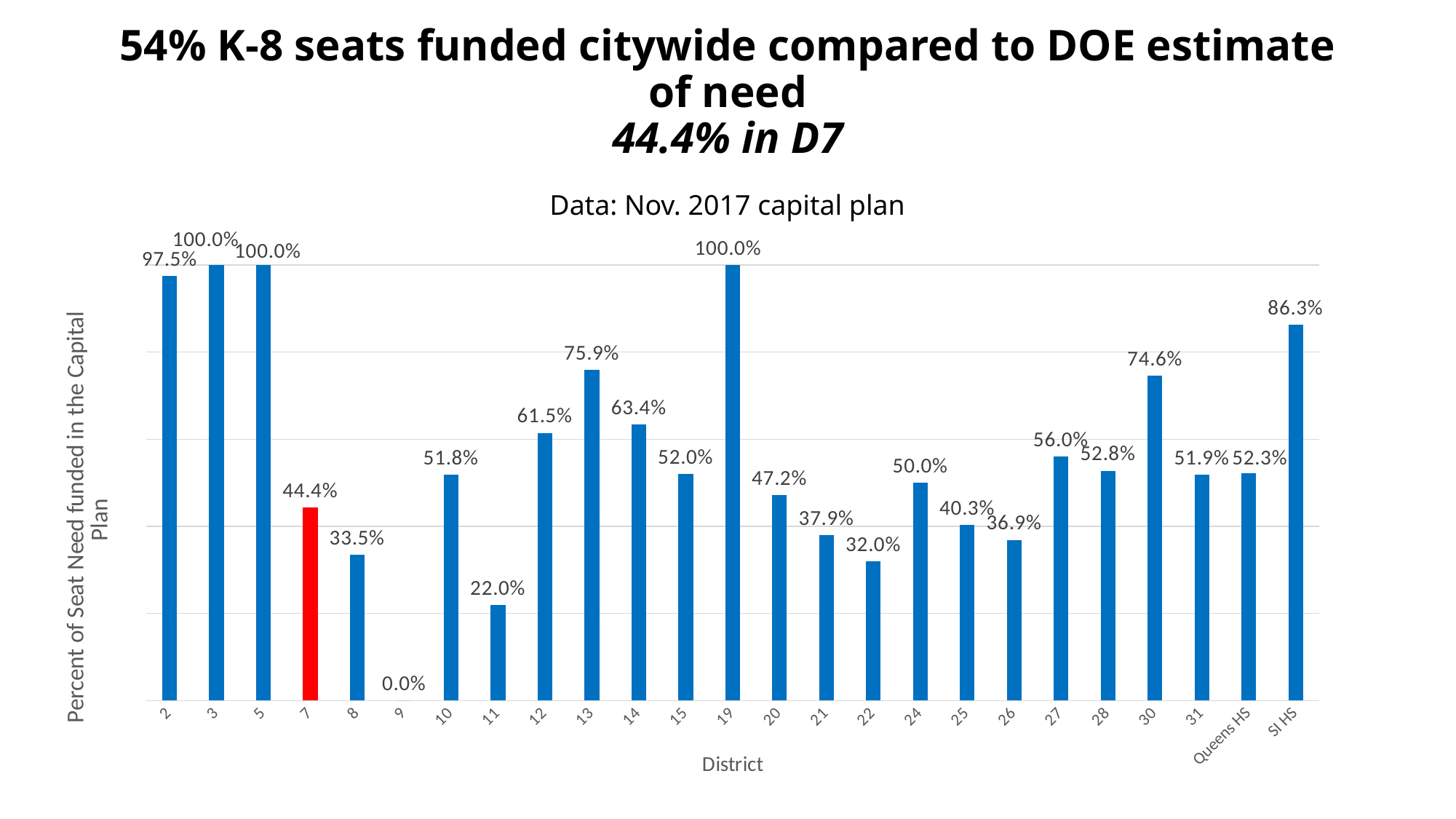
What is the value for SI HS? 86.3% How many districts are shown on the x axis? 25 What is the difference between the values for SI HS and district 30? 11.7 percentage points Which district has the lowest value? 9 What is the value for district 11? 22.0% Which bar is coloured red instead of blue? District 7 Which is larger, the value for district 27 or district 28? District 27 What kind of chart is this? Bar chart Which is larger, the value for district 21 or district 25? District 25 What is the value for district 7? 44.4% What is the difference between the values for district 13 and district 14? 12.5 percentage points What is the value for district 13? 75.9%